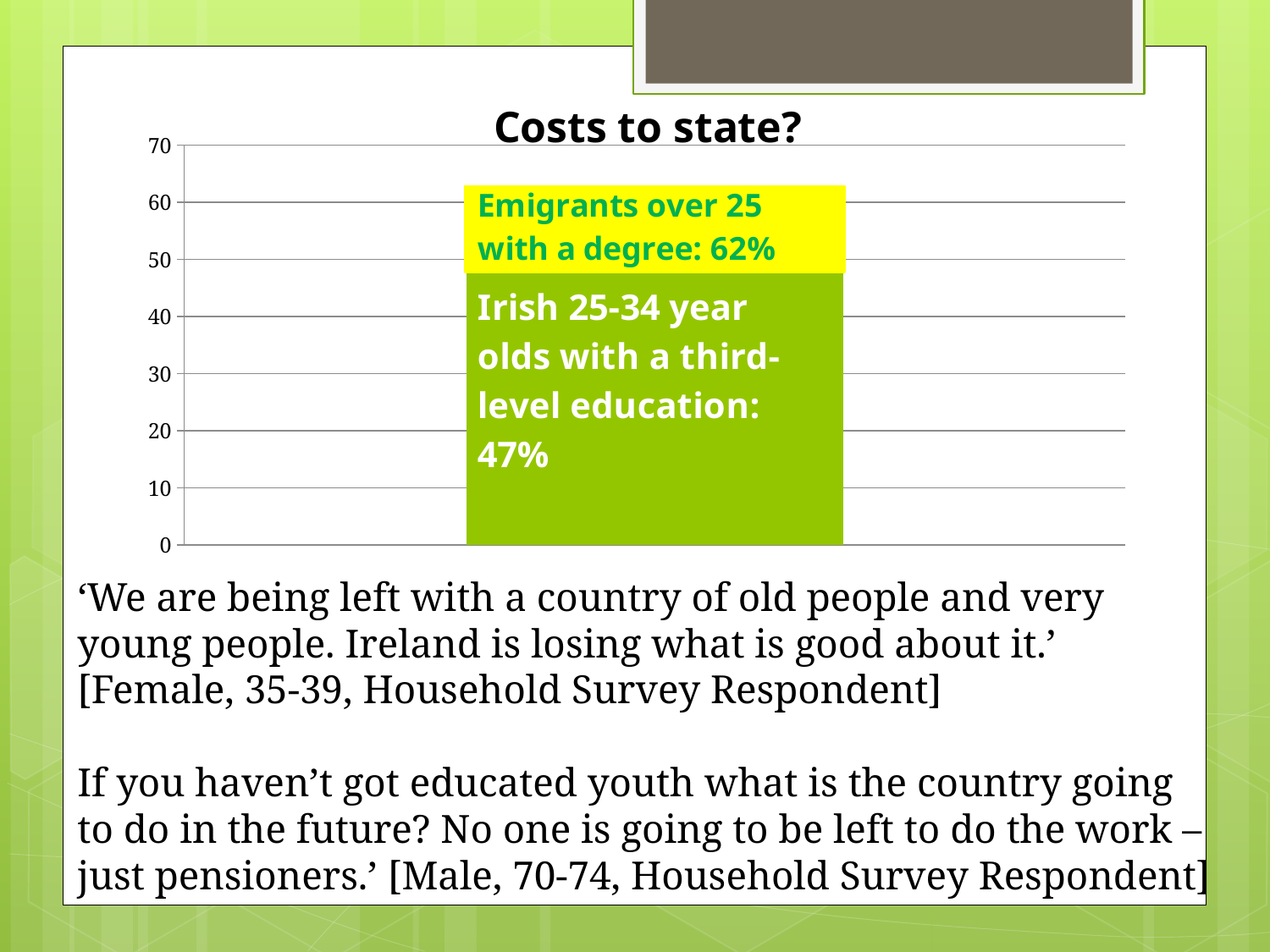
Is the value for Irish 25-34 year olds with a third-level education greater or less than 50? less Which group has the lower value on the chart? Irish 25-34 year olds with a third-level education What is the difference between the value for emigrants over 25 with a degree and the value for Irish 25-34 year olds with a third-level education? 15 percentage points Which group has the higher value: emigrants over 25 with a degree or Irish 25-34 year olds with a third-level education? Emigrants over 25 with a degree What kind of chart is shown on the slide? Bar chart What value is shown for Irish 25-34 year olds with a third-level education? 47% What is the title of the chart? Costs to state? Is the value for emigrants over 25 with a degree greater or less than 60? greater What value is shown for emigrants over 25 with a degree? 62% What is the highest value shown on the chart's vertical axis? 70 Is the value for Irish 25-34 year olds with a third-level education larger or smaller than the value for emigrants over 25 with a degree? Smaller